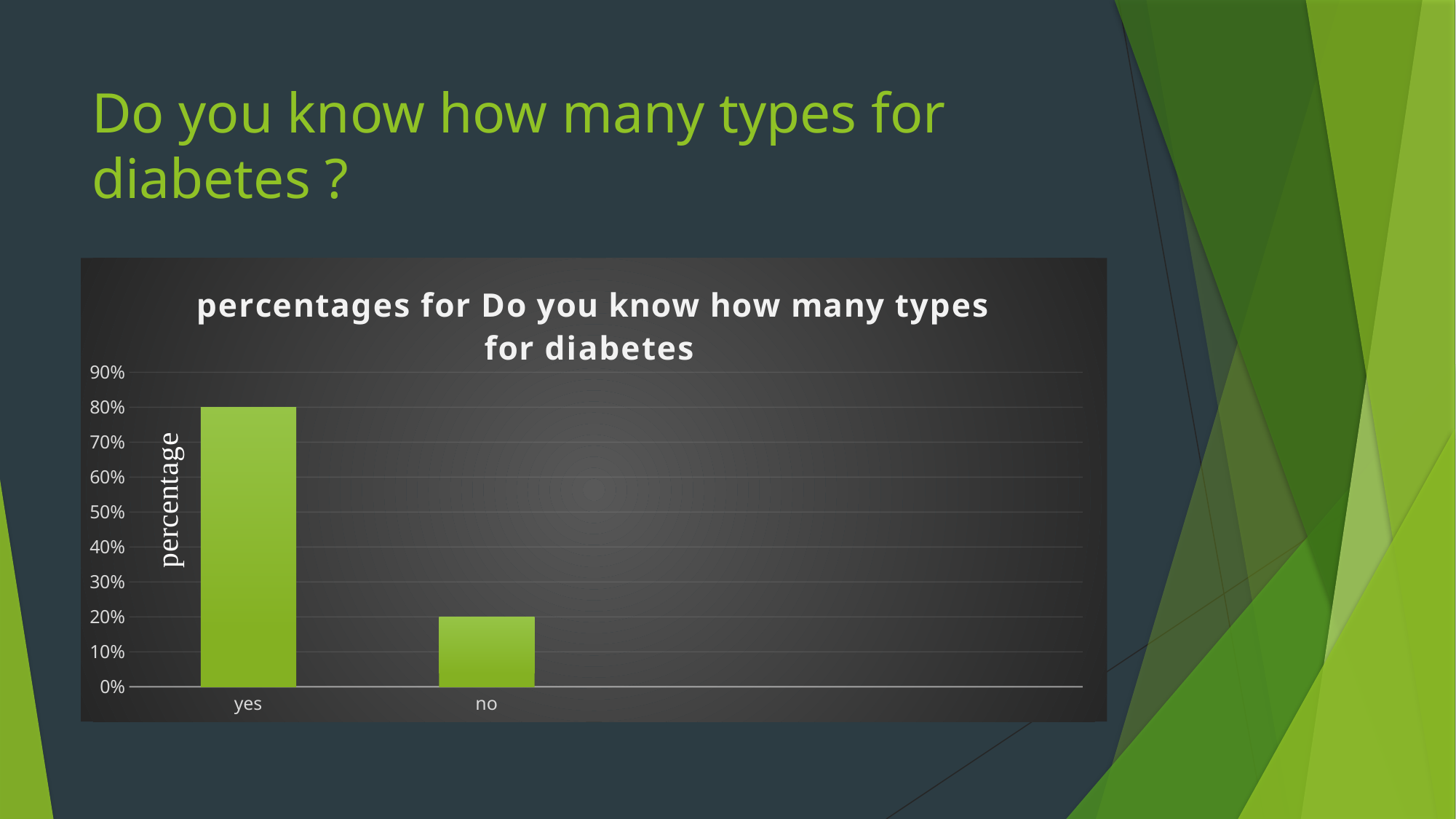
How many categories are shown on the x axis? 2 What is the difference between the percentages for "yes" and "no"? 60% What type of chart is shown on the slide? bar chart What is the title of the chart? percentages for Do you know how many types for diabetes What is the percentage for "no"? 20% Is the value for "yes" greater or less than 70%? greater What is the label of the vertical axis? percentage Which is larger, the percentage for "yes" or for "no"? yes What is the percentage for "yes"? 80% Is the value for "no" greater or less than 50%? less Which category has the lowest percentage? no Which category has the highest percentage? yes